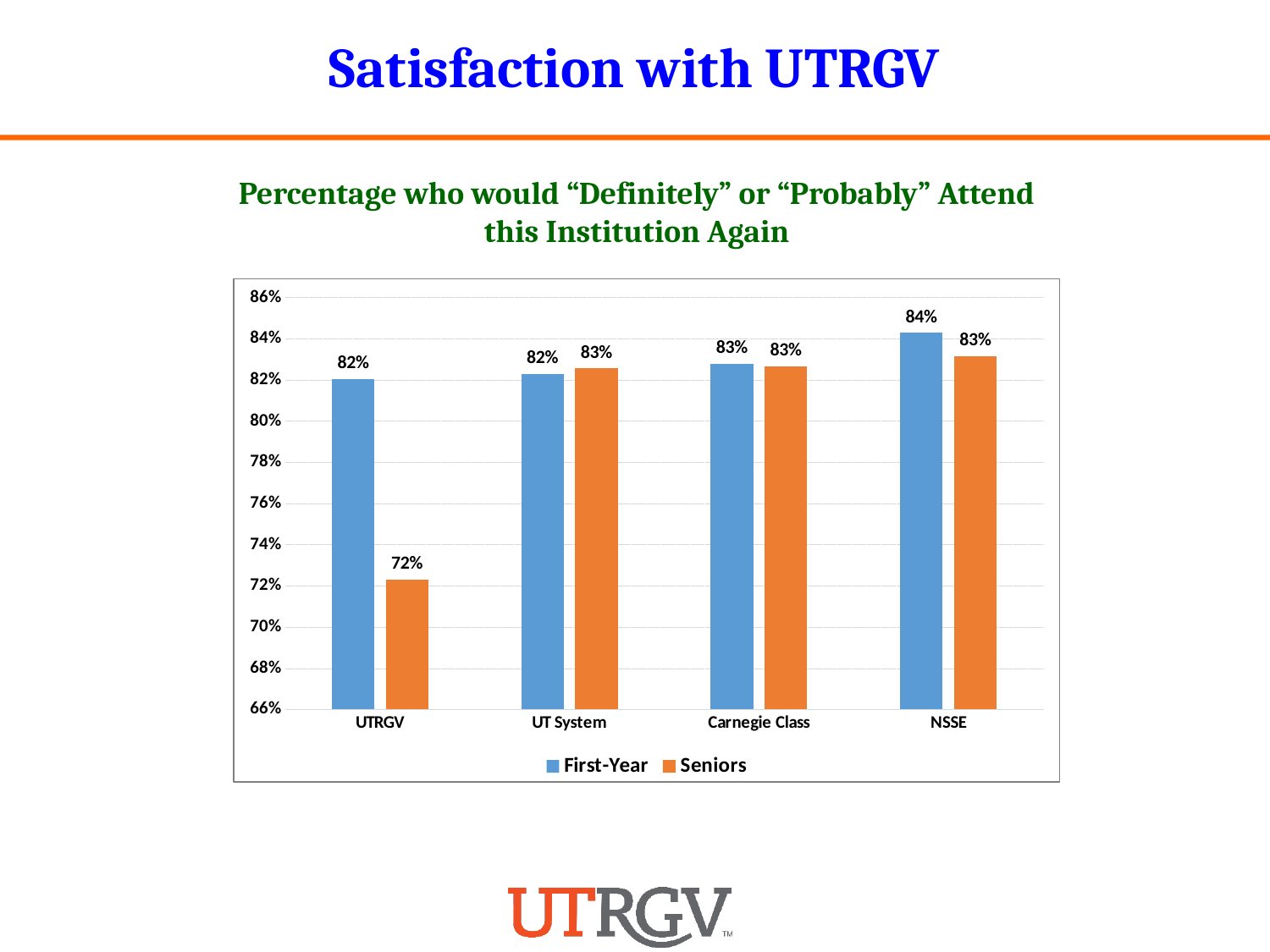
How many series does the legend list? 2 For UTRGV, which is larger: the First-Year value or the Seniors value? First-Year What is the Seniors value for UTRGV? 72% Is the Seniors value for UTRGV greater or less than 74%? less Which category has the lowest Seniors value? UTRGV Which category has the highest First-Year value? NSSE What kind of chart is shown on the slide? bar chart What is the First-Year value for NSSE? 84% How many categories are shown on the x axis? 4 What is the First-Year value for UTRGV? 82% What is the difference between the First-Year and Seniors values for UTRGV? 10% What is the Seniors value for Carnegie Class? 83%